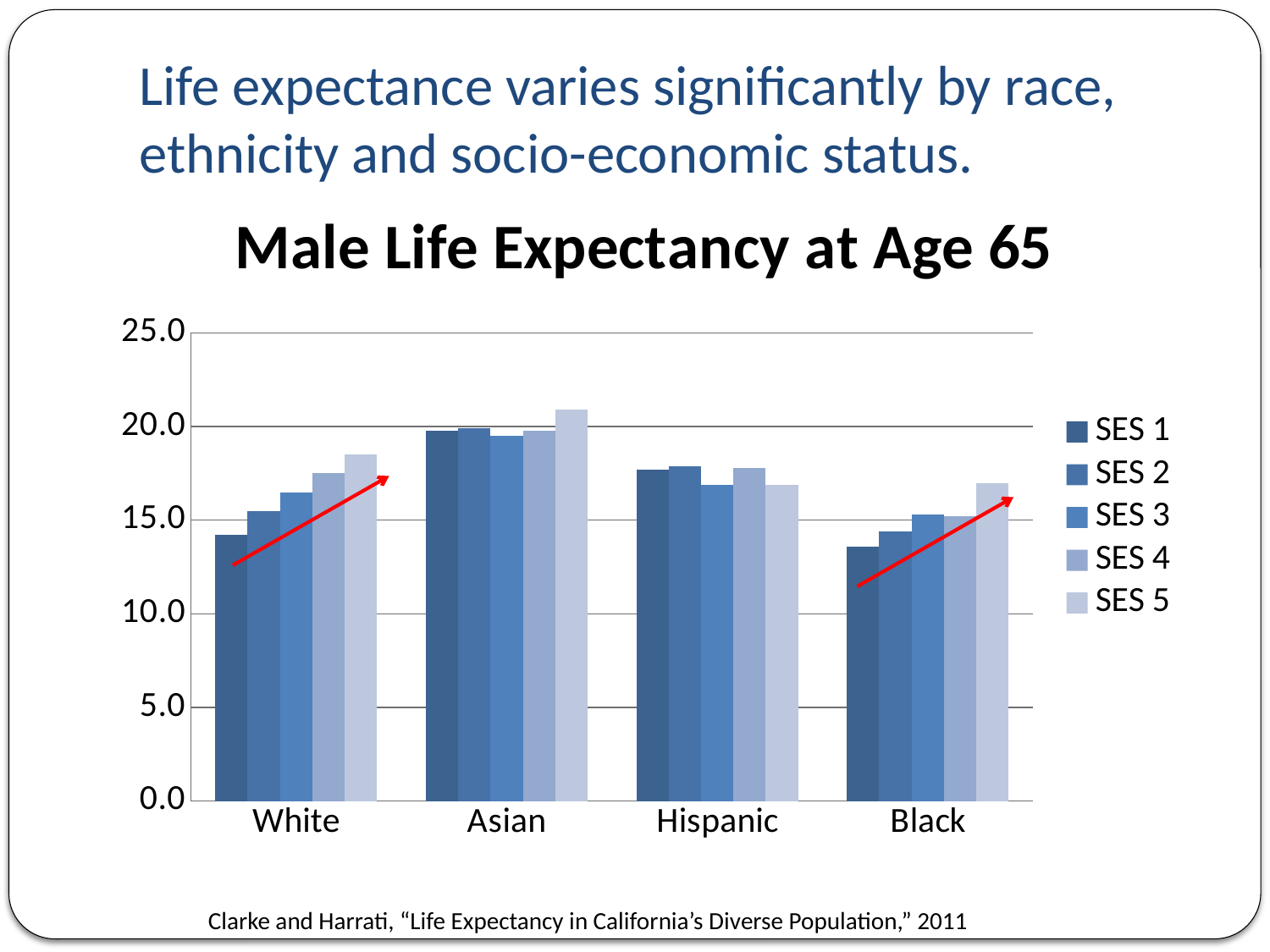
Is the value for SES 1 in the Hispanic group greater or less than 15.0? greater Which group has the highest SES 5 bar? Asian How many series does the legend list? 5 For the White group, do the values rise or fall from SES 1 to SES 5? rise How many racial/ethnic groups are shown on the x axis? 4 What kind of chart is shown on the slide? bar chart Which is larger, the SES 5 value for White or the SES 5 value for Black? White Is the value for SES 1 in the Black group greater or less than 15.0? less Which group has the lowest SES 1 bar? Black What is the title of the chart? Male Life Expectancy at Age 65 Is the value for SES 1 in the White group greater or less than 15.0? less